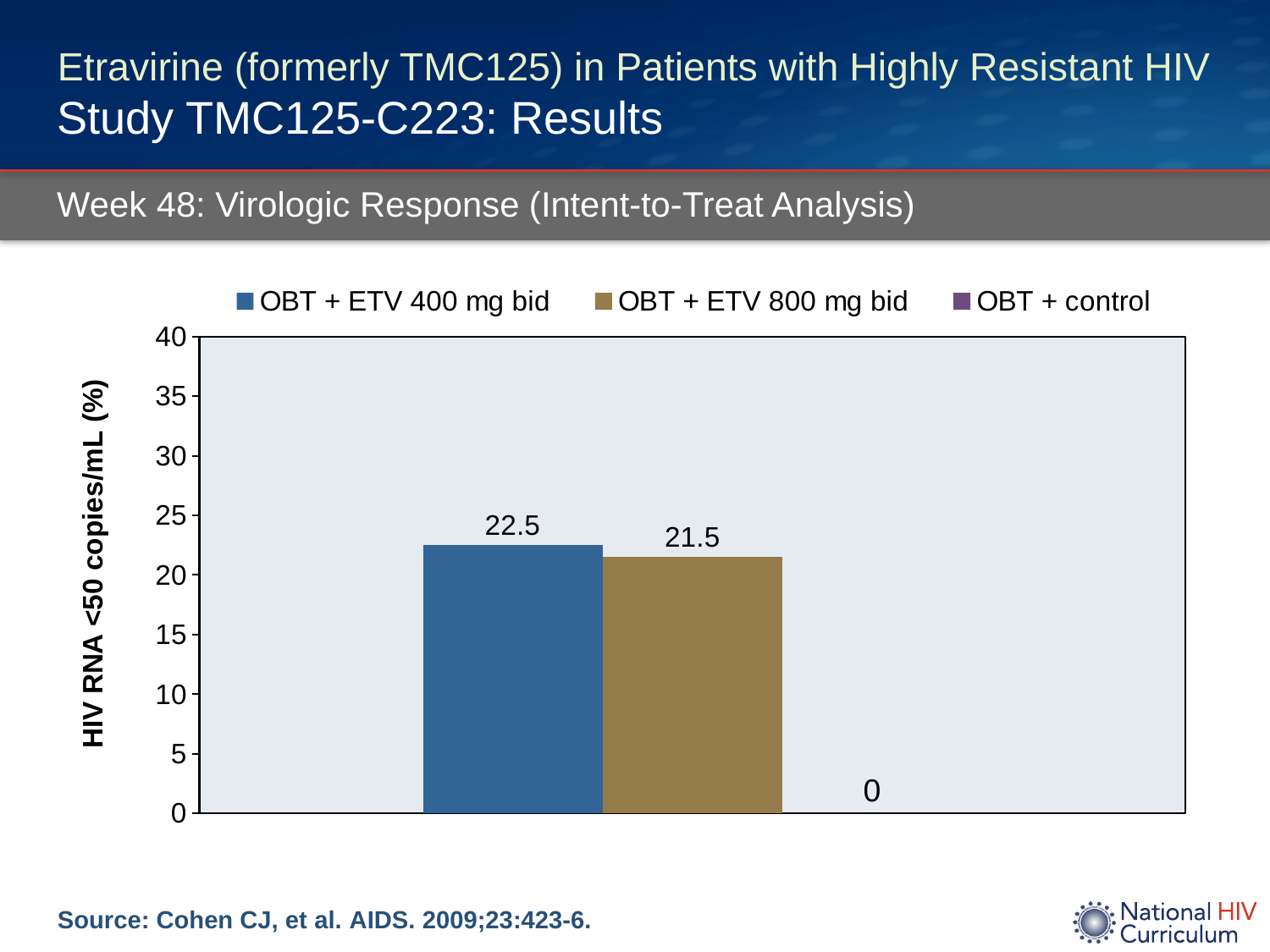
What is the difference between the values for OBT + ETV 400 mg bid and OBT + ETV 800 mg bid? 1 Is the value for OBT + ETV 400 mg bid greater or less than 25? less What is the value for OBT + ETV 400 mg bid? 22.5 What is the value for OBT + ETV 800 mg bid? 21.5 What is the maximum value shown on the y axis? 40 How many series does the legend list? 3 Which is larger, the value for OBT + ETV 800 mg bid or the value for OBT + control? OBT + ETV 800 mg bid Which series has the highest value? OBT + ETV 400 mg bid What is the label of the y axis? HIV RNA <50 copies/mL (%) What kind of chart is shown? bar chart Which series has the lowest value? OBT + control What is the value for OBT + control? 0